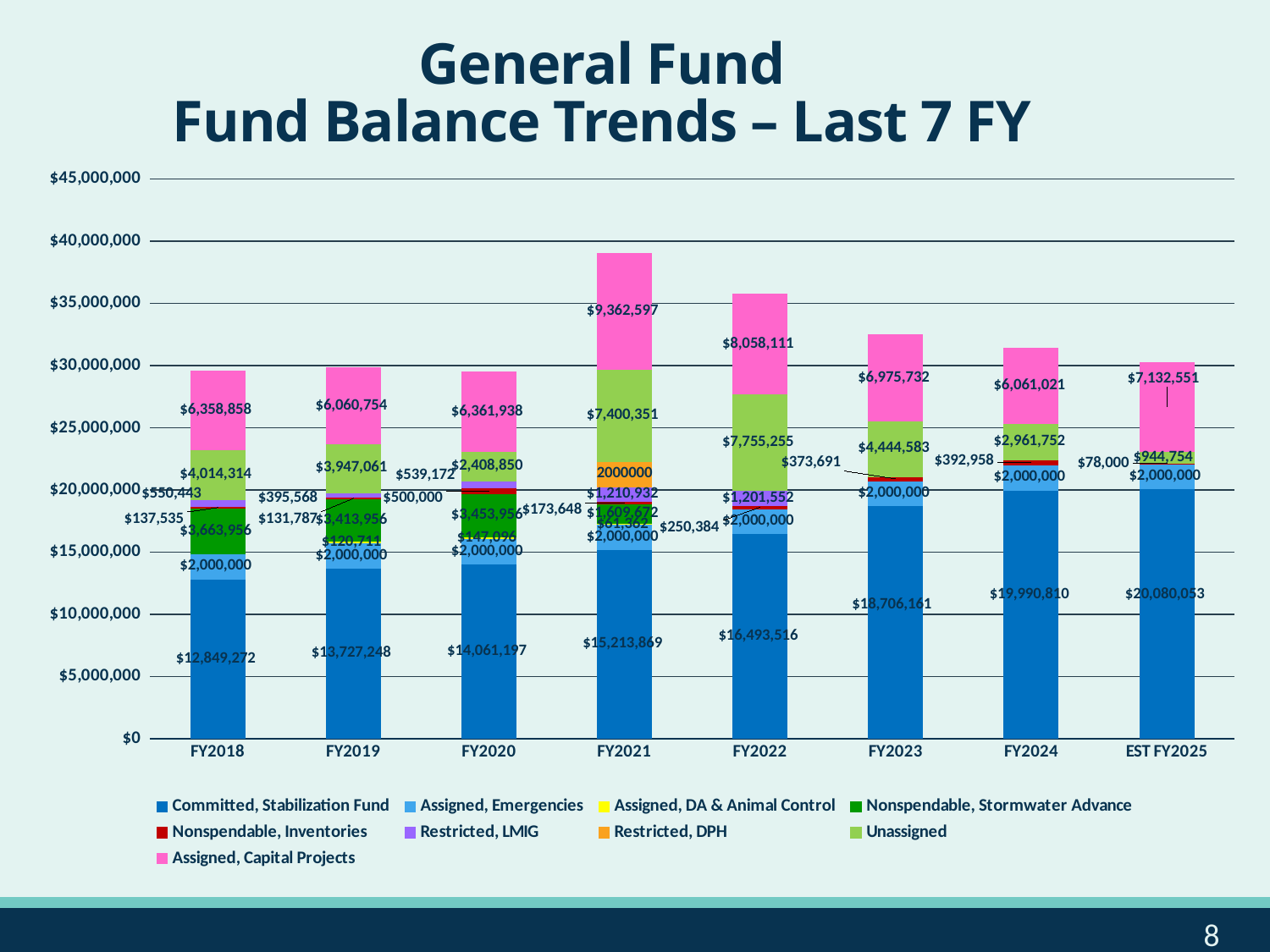
What is the Unassigned value for EST FY2025? $944,754 In which fiscal year is the Unassigned value the lowest? EST FY2025 What is the Committed, Stabilization Fund value for FY2022? $16,493,516 How many fiscal years are shown along the x axis? 8 What is the difference between the Committed, Stabilization Fund values for FY2024 and FY2023? $1,284,649 How many series does the legend list? 9 Does the Committed, Stabilization Fund value rise or fall from FY2018 to EST FY2025? Rises What kind of chart is shown on the slide? Stacked bar chart In which fiscal year is the Committed, Stabilization Fund value the highest? EST FY2025 In which fiscal year is the Assigned, Capital Projects value the highest? FY2021 What is the Assigned, Capital Projects value for FY2021? $9,362,597 Which year has the larger Unassigned value, FY2021 or FY2022? FY2022